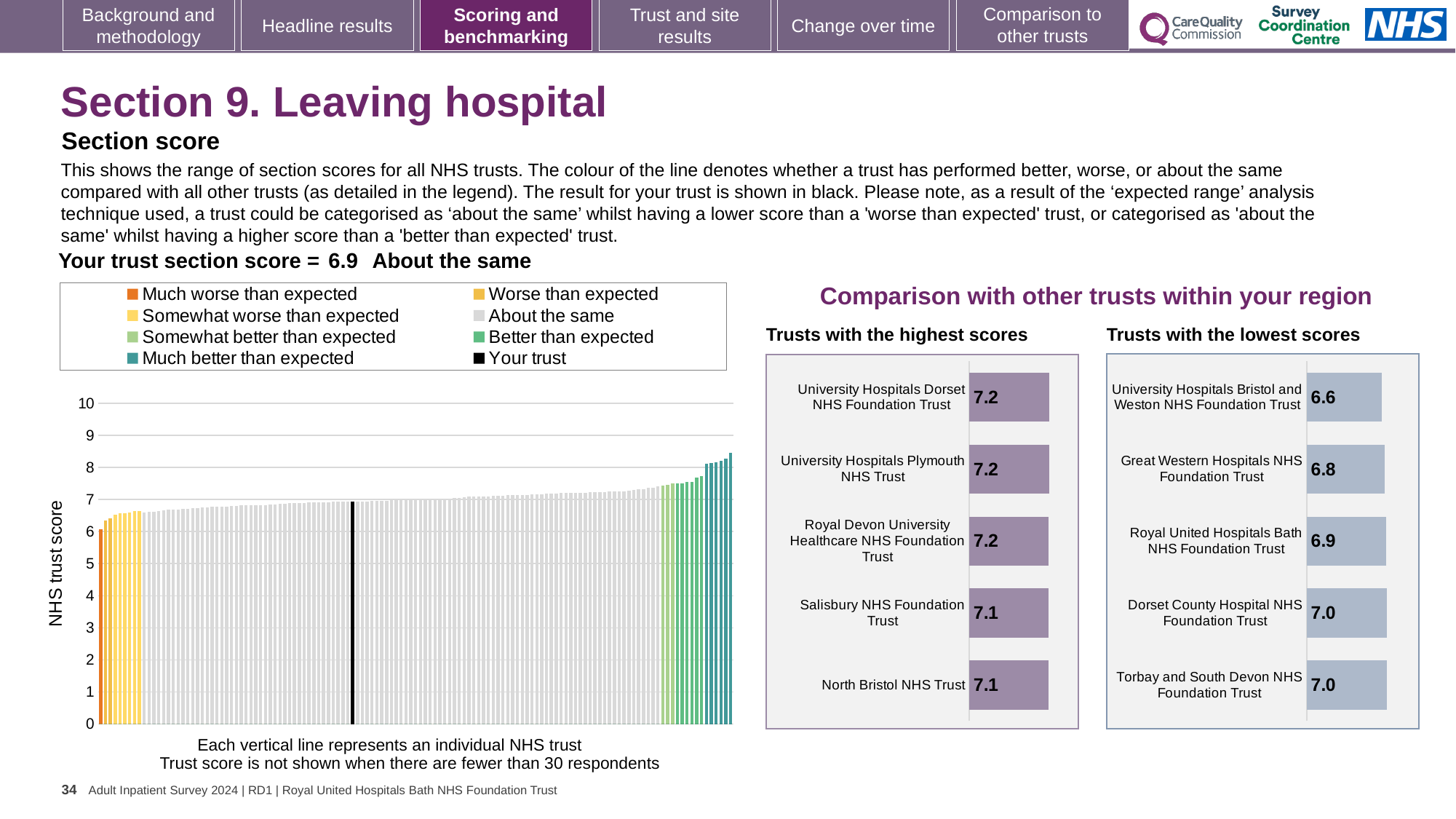
In the 'Trusts with the lowest scores' chart, which trust has the lowest score? University Hospitals Bristol and Weston NHS Foundation Trust In the 'Trusts with the highest scores' chart, which has the higher score: University Hospitals Dorset NHS Foundation Trust or North Bristol NHS Trust? University Hospitals Dorset NHS Foundation Trust What kind of chart is the large chart on the left showing NHS trust scores? Bar chart In the 'Trusts with the highest scores' chart, what is the score for Salisbury NHS Foundation Trust? 7.1 How many trusts are listed in the 'Trusts with the highest scores' chart? 5 In the large chart on the left, what is the section score for your trust? 6.9 How many entries does the legend of the large chart on the left list? 8 In the 'Trusts with the lowest scores' chart, what is the difference between the scores of Great Western Hospitals NHS Foundation Trust and University Hospitals Bristol and Weston NHS Foundation Trust? 0.2 In the 'Trusts with the highest scores' chart, what is the difference between the scores of University Hospitals Dorset NHS Foundation Trust and Salisbury NHS Foundation Trust? 0.1 How many trusts are listed in the 'Trusts with the lowest scores' chart? 5 In the 'Trusts with the lowest scores' chart, what is the score for Torbay and South Devon NHS Foundation Trust? 7.0 In the 'Trusts with the lowest scores' chart, what is the score for Great Western Hospitals NHS Foundation Trust? 6.8